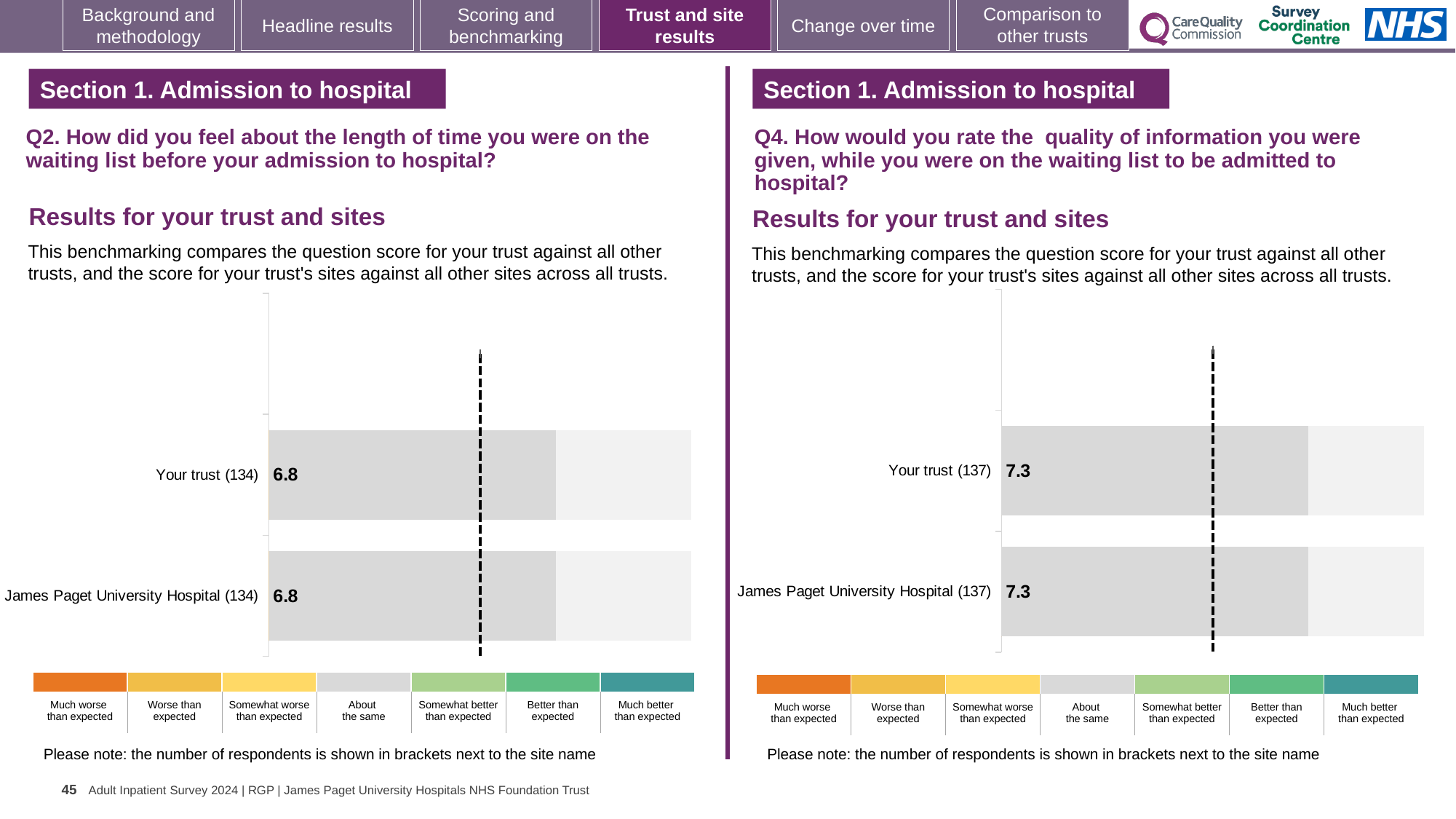
On the Q2 chart (left), what is the score for James Paget University Hospital? 6.8 On the Q4 chart (right), how many respondents are shown in brackets for James Paget University Hospital? 137 On the Q4 chart (right), what is the score for James Paget University Hospital? 7.3 On the Q4 chart (right), what is the score for Your trust? 7.3 On the Q2 chart (left), what is the score for Your trust? 6.8 On the Q2 chart (left), how many respondents are shown in brackets for Your trust? 134 How many bars are plotted on the Q2 chart (left)? 2 What kind of chart is the Q2 chart (left)? Bar chart Is the score for Your trust on the Q4 chart (right) larger than the score for Your trust on the Q2 chart (left)? Yes On the Q2 chart (left), what is the difference between the score for Your trust and the score for James Paget University Hospital? 0 On the Q4 chart (right), what is the difference between the score for Your trust and the score for James Paget University Hospital? 0 How many bars are plotted on the Q4 chart (right)? 2